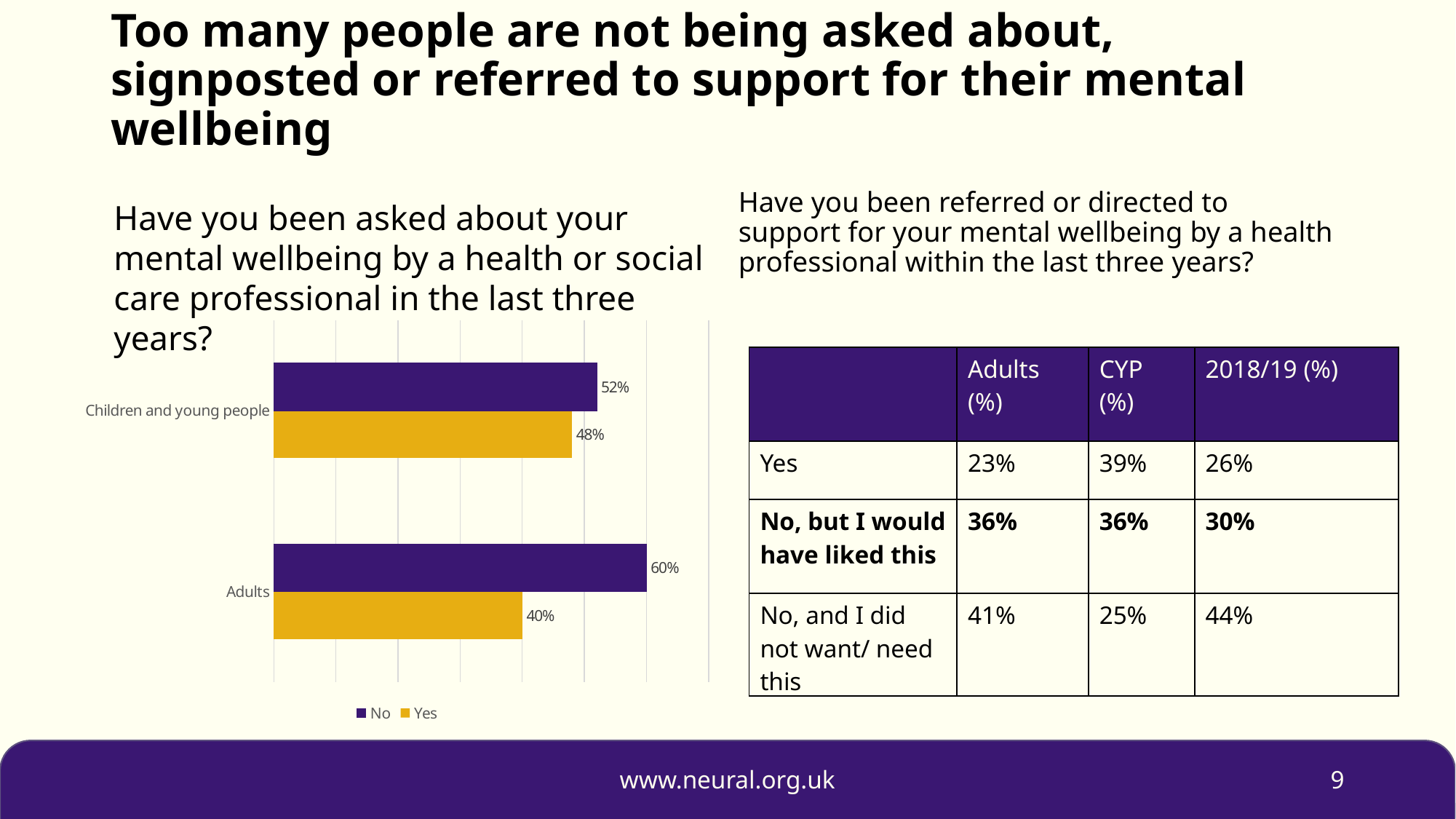
Which group has the higher "No" value in the bar chart, adults or children and young people? Adults How many categories are shown on the bar chart? 2 What percentage of children and young people answered "No" in the bar chart? 52% What is the difference between the "No" values for adults and for children and young people in the bar chart? 8% What percentage of adults answered "No" to being asked about their mental wellbeing by a health or social care professional in the last three years? 60% What type of chart is used to show whether people have been asked about their mental wellbeing? Bar chart Which group has the lowest "Yes" value in the bar chart? Adults What percentage of children and young people answered "Yes" in the bar chart? 48% What is the difference between the "No" and "Yes" values for adults in the bar chart? 20% Which colour represents the "Yes" series in the bar chart? Gold How many series does the legend of the bar chart list? 2 What percentage of adults answered "Yes" in the bar chart? 40%